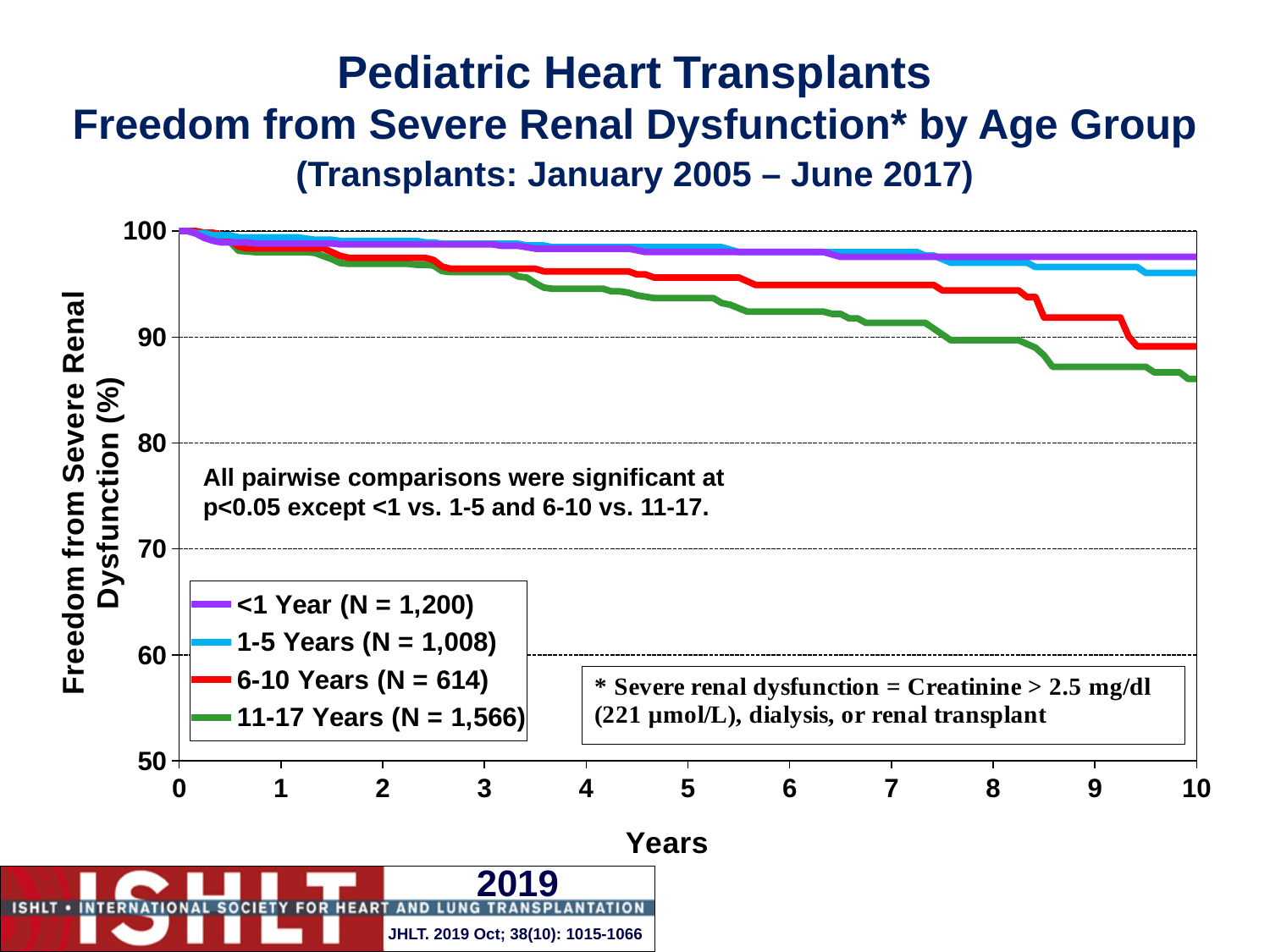
What kind of chart is shown on the slide? line chart How many age groups (series) does the legend list? 4 Which age group has the highest freedom from severe renal dysfunction at 10 years? <1 Year At 10 years, which group has higher freedom from severe renal dysfunction: 6-10 Years or 11-17 Years? 6-10 Years Which age group has the lowest freedom from severe renal dysfunction at 10 years? 11-17 Years Do the curves rise or fall as years since transplant increase? fall What is the N for the 6-10 Years group shown in the legend? 614 At 10 years, is the freedom from severe renal dysfunction for the <1 Year group greater or less than 90? greater What is the N for the 11-17 Years group shown in the legend? 1,566 At 10 years, is the freedom from severe renal dysfunction for the 11-17 Years group greater or less than 90? less At 5 years, is the freedom from severe renal dysfunction for the 11-17 Years group greater or less than 90? greater What is the N for the <1 Year group shown in the legend? 1,200